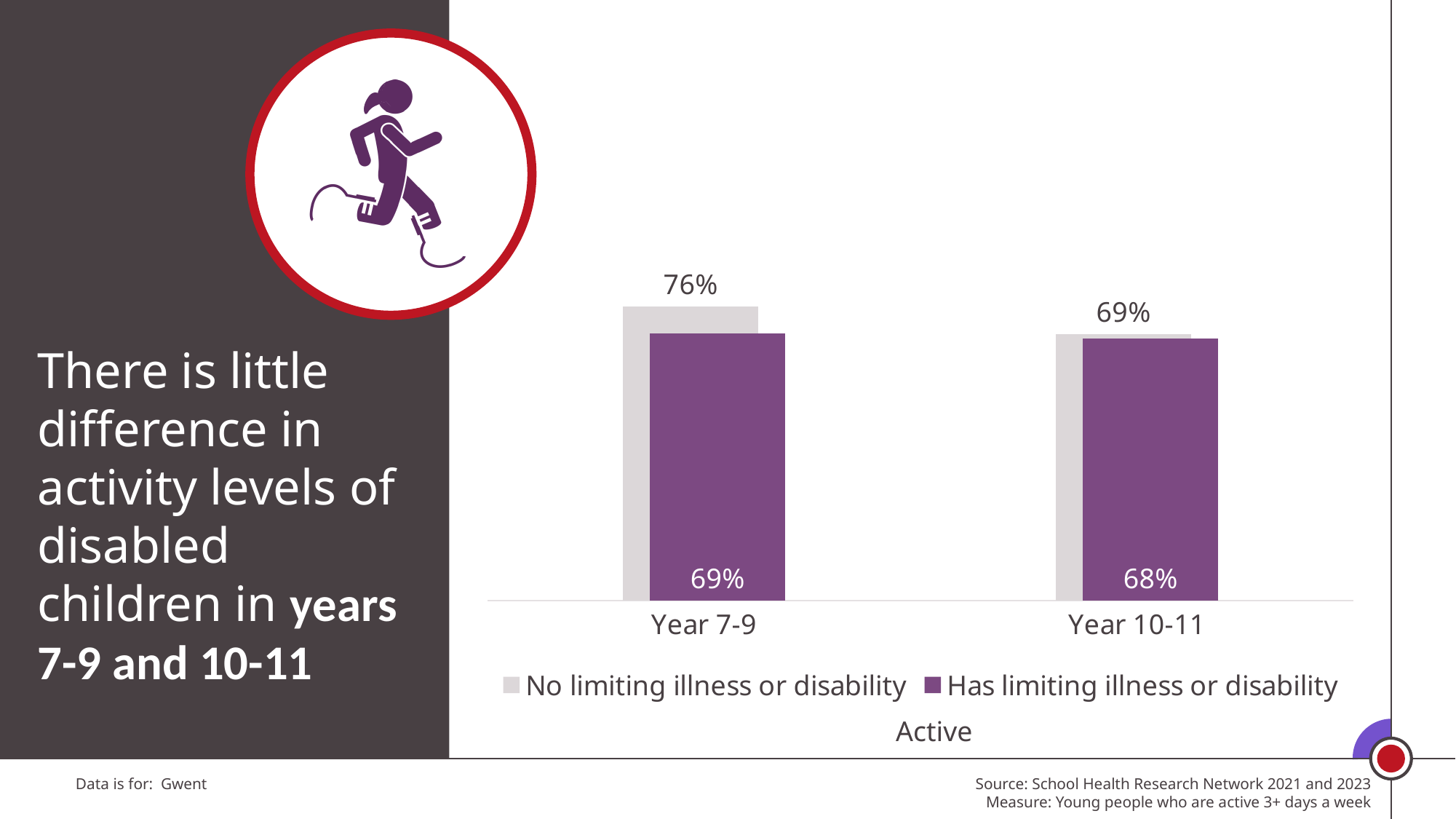
What percentage of Year 10-11 pupils with no limiting illness or disability are active? 69% What percentage of Year 10-11 pupils who have a limiting illness or disability are active? 68% What is the difference between the 'No limiting illness or disability' and 'Has limiting illness or disability' values for Year 10-11? 1 percentage point What is the difference between the 'No limiting illness or disability' and 'Has limiting illness or disability' values for Year 7-9? 7 percentage points What type of chart is shown on the slide? Bar chart How many series does the legend list? 2 How many year-group categories are shown on the x axis? 2 What percentage of Year 7-9 pupils who have a limiting illness or disability are active? 69% Which year group has the higher value for 'No limiting illness or disability'? Year 7-9 Which bar in the chart has the lowest value? Has limiting illness or disability, Year 10-11 What percentage of Year 7-9 pupils with no limiting illness or disability are active? 76% Which bar in the chart has the highest value? No limiting illness or disability, Year 7-9